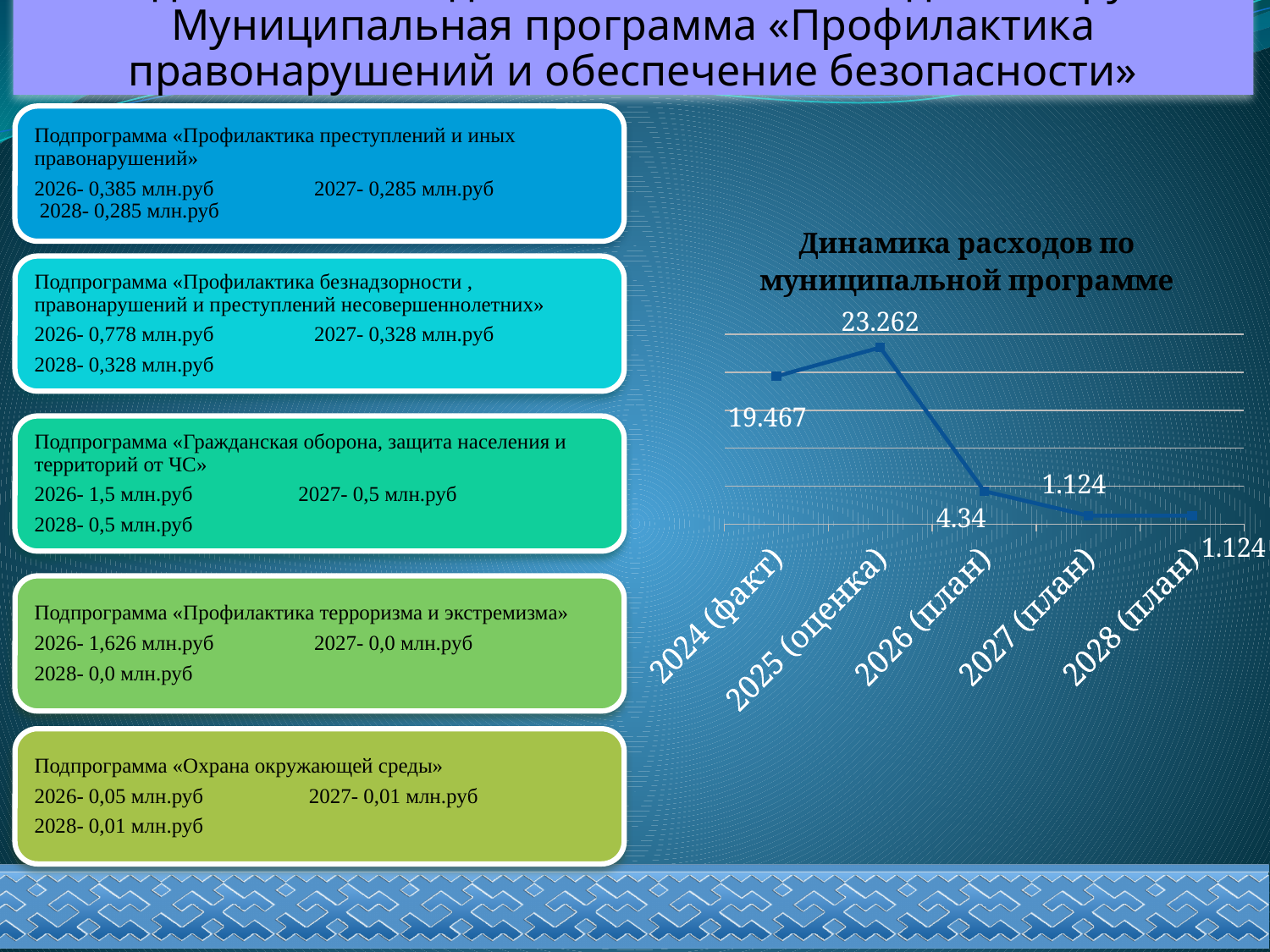
Which is larger, the value for 2024 (факт) or the value for 2026 (план)? 2024 (факт) What is the difference between the values for 2025 (оценка) and 2024 (факт)? 3.795 What is the value for 2025 (оценка)? 23.262 What type of chart is shown on the slide? line chart Which category has the highest value? 2025 (оценка) Do the values rise or fall from 2025 (оценка) to 2028 (план)? fall What is the value for 2027 (план)? 1.124 What is the difference between the values for 2026 (план) and 2027 (план)? 3.216 What is the value for 2026 (план)? 4.34 What is the title of the chart on the slide? Динамика расходов по муниципальной программе What is the value for 2024 (факт)? 19.467 How many data points are plotted on the chart? 5